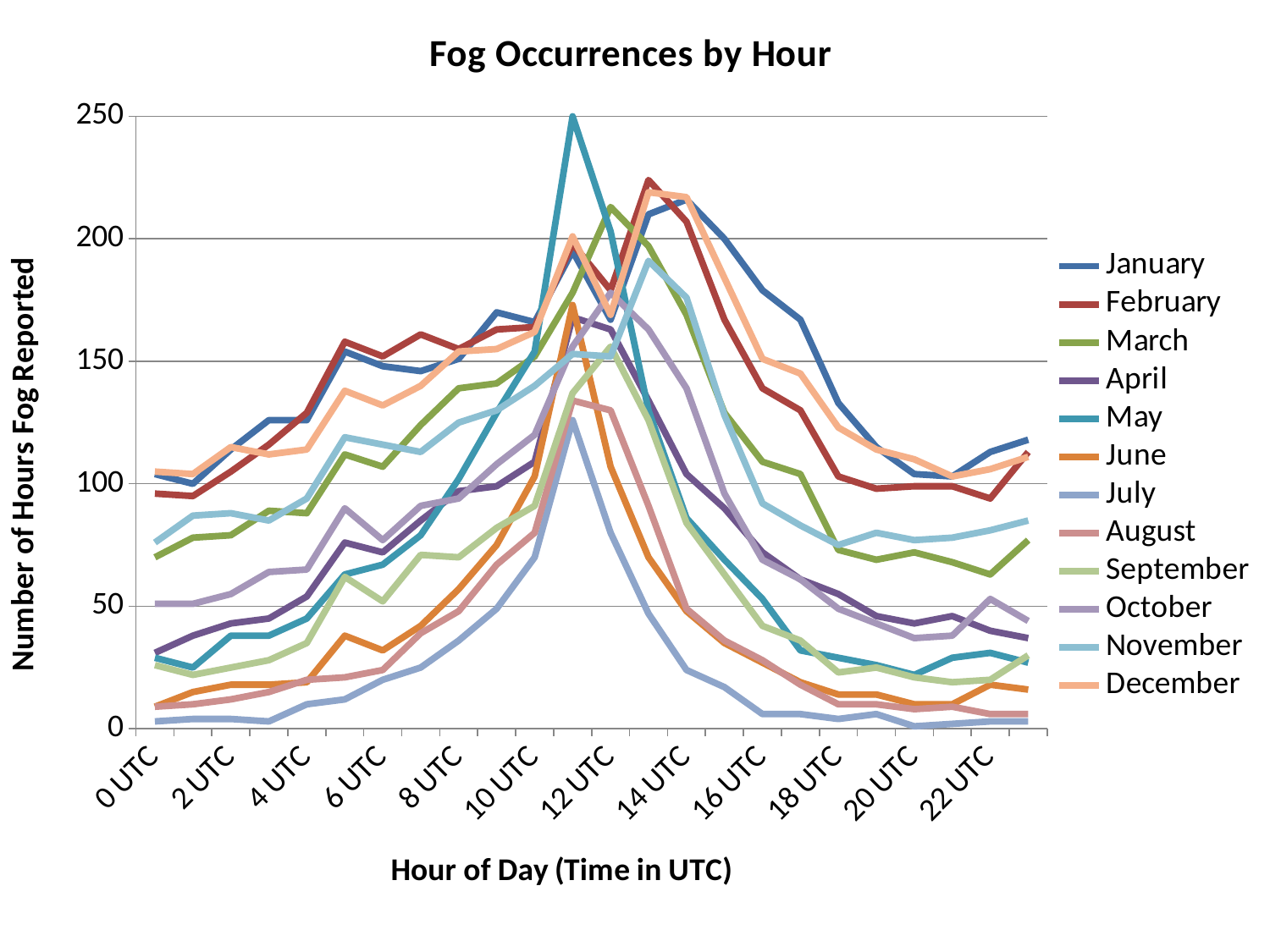
How many series does the legend list? 12 Is the value for July at 0 UTC greater or less than 50? less What is the label of the vertical axis? Number of Hours Fog Reported Which series stays lowest across most of the day? July Is the value for June at 11 UTC greater or less than 150? greater At 11 UTC, which is larger, the value for May or the value for July? May What kind of chart is shown on the slide? line chart Does the July line rise or fall between 12 UTC and 16 UTC? fall Is the value for March at 12 UTC greater or less than 200? greater Which series reaches the highest value anywhere on the chart? May What is the title of the chart? Fog Occurrences by Hour